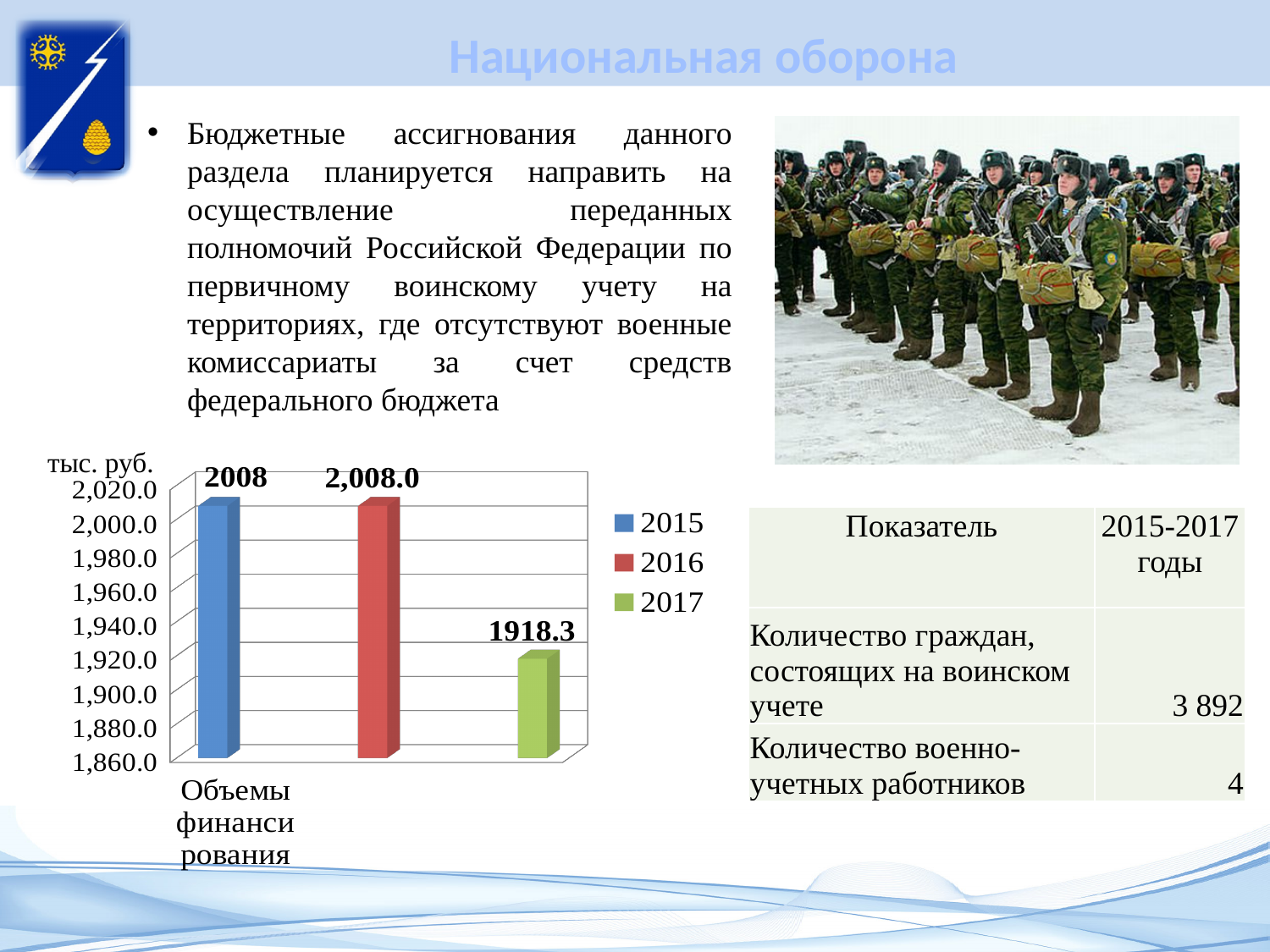
Which is larger in the chart, the value for 2016 or the value for 2017? 2016 What is the value shown for the 2016 series in the chart? 2,008.0 What is the value shown for the 2017 series in the chart? 1918.3 Is the value for 2015 in the chart greater or less than 2,000.0? greater What kind of chart is shown on the slide? bar chart Which series has the lowest value in the chart? 2017 What is the value shown for the 2015 series in the chart? 2008 What is the category label shown under the bars in the chart? Объемы финансирования What unit is indicated on the chart's vertical axis? тыс. руб. Is the value for 2017 in the chart greater or less than 1,940.0? less What is the difference between the 2016 value and the 2017 value in the chart? 89.7 How many series does the chart legend list? 3